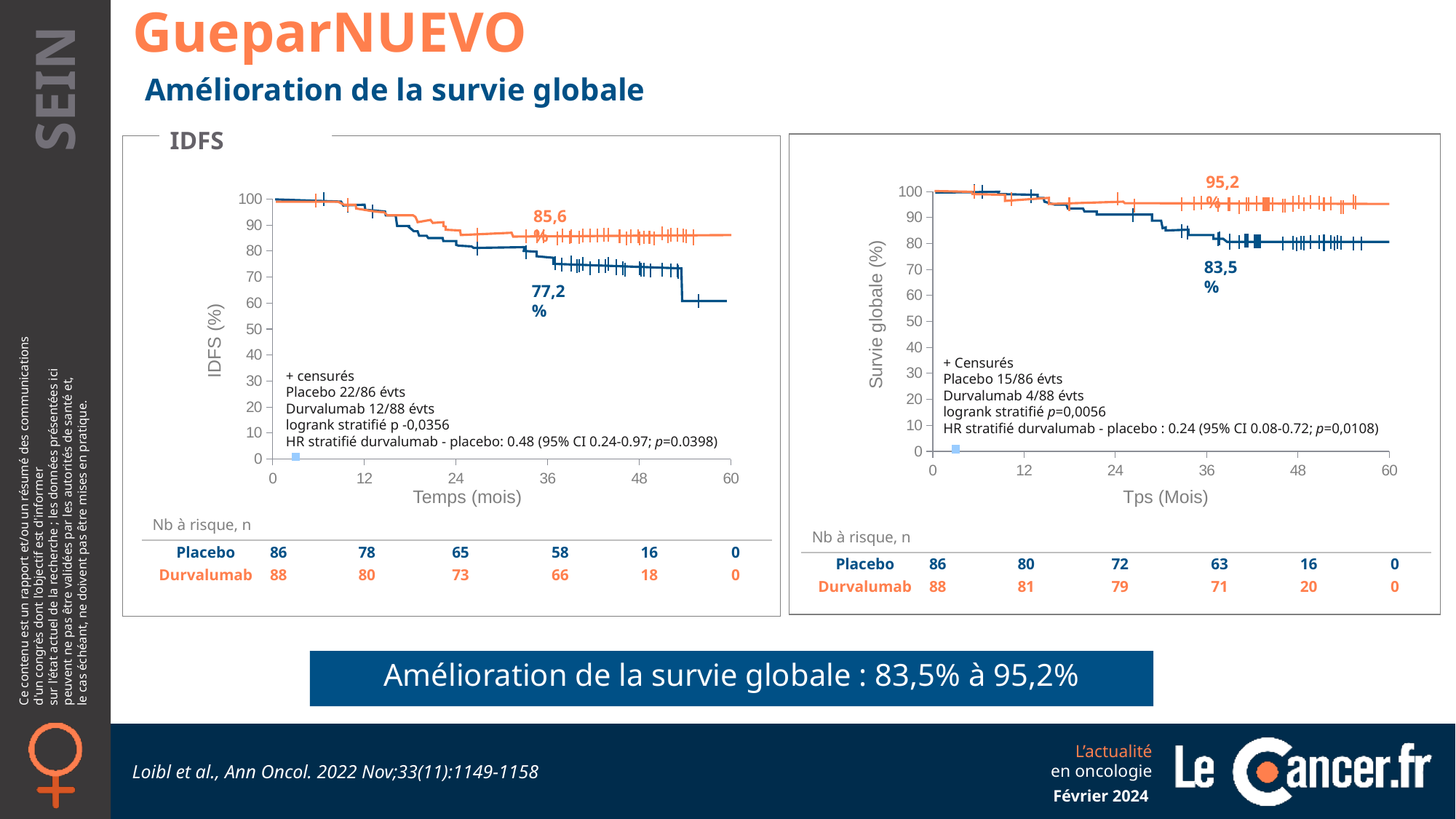
On the Survie globale chart, do the curves rise or fall as time increases along the x axis? fall What kind of chart is shown in the IDFS panel? Line chart (Kaplan-Meier survival curves) On the IDFS chart, is the Placebo curve at 60 months greater or less than 70? less On the IDFS chart, what is the difference between the labelled Durvalumab and Placebo IDFS values? 8,4 % On the IDFS chart, which curve is higher, Durvalumab or Placebo? Durvalumab On the Survie globale chart, what is the labelled overall survival value for the Placebo (blue) curve? 83,5 % On the IDFS chart, what is the labelled IDFS value for the Durvalumab (orange) curve? 85,6 % On the Survie globale chart, what is the labelled overall survival value for the Durvalumab (orange) curve? 95,2 % On the IDFS chart, how many patients in the Placebo group were at risk at 12 months? 78 On the Survie globale chart, what is the difference between the labelled Durvalumab and Placebo survival values? 11,7 % On the IDFS chart, what is the labelled IDFS value for the Placebo (blue) curve? 77,2 % On the Survie globale chart, how many treatment groups are plotted? 2